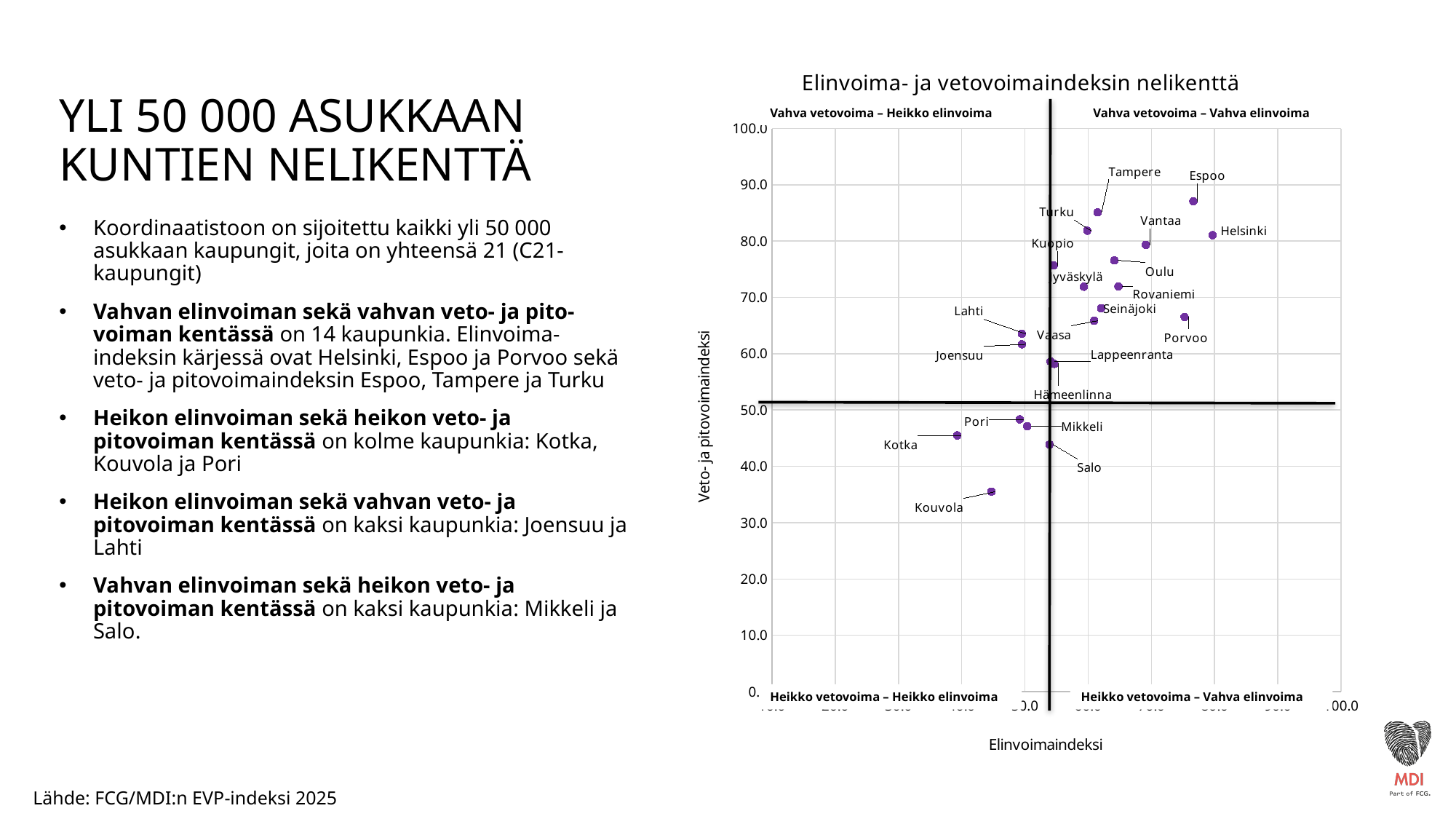
Which city is plotted furthest to the left on the Elinvoimaindeksi axis? Kotka Is the Veto- ja pitovoimaindeksi value for Kotka greater or less than 50.0? less Is the Veto- ja pitovoimaindeksi value for Porvoo greater or less than 60.0? greater What kind of chart is shown on the slide? scatter chart How many cities are plotted as points in the chart? 21 What is the label of the vertical axis of the chart? Veto- ja pitovoimaindeksi Which city has the highest value on the Veto- ja pitovoimaindeksi axis? Espoo Is the Veto- ja pitovoimaindeksi value for Kouvola greater or less than 40.0? less Which city has the lowest value on the Veto- ja pitovoimaindeksi axis? Kouvola Which city has a higher Veto- ja pitovoimaindeksi value, Kotka or Kouvola? Kotka What is the title of the chart? Elinvoima- ja vetovoimaindeksin nelikenttä